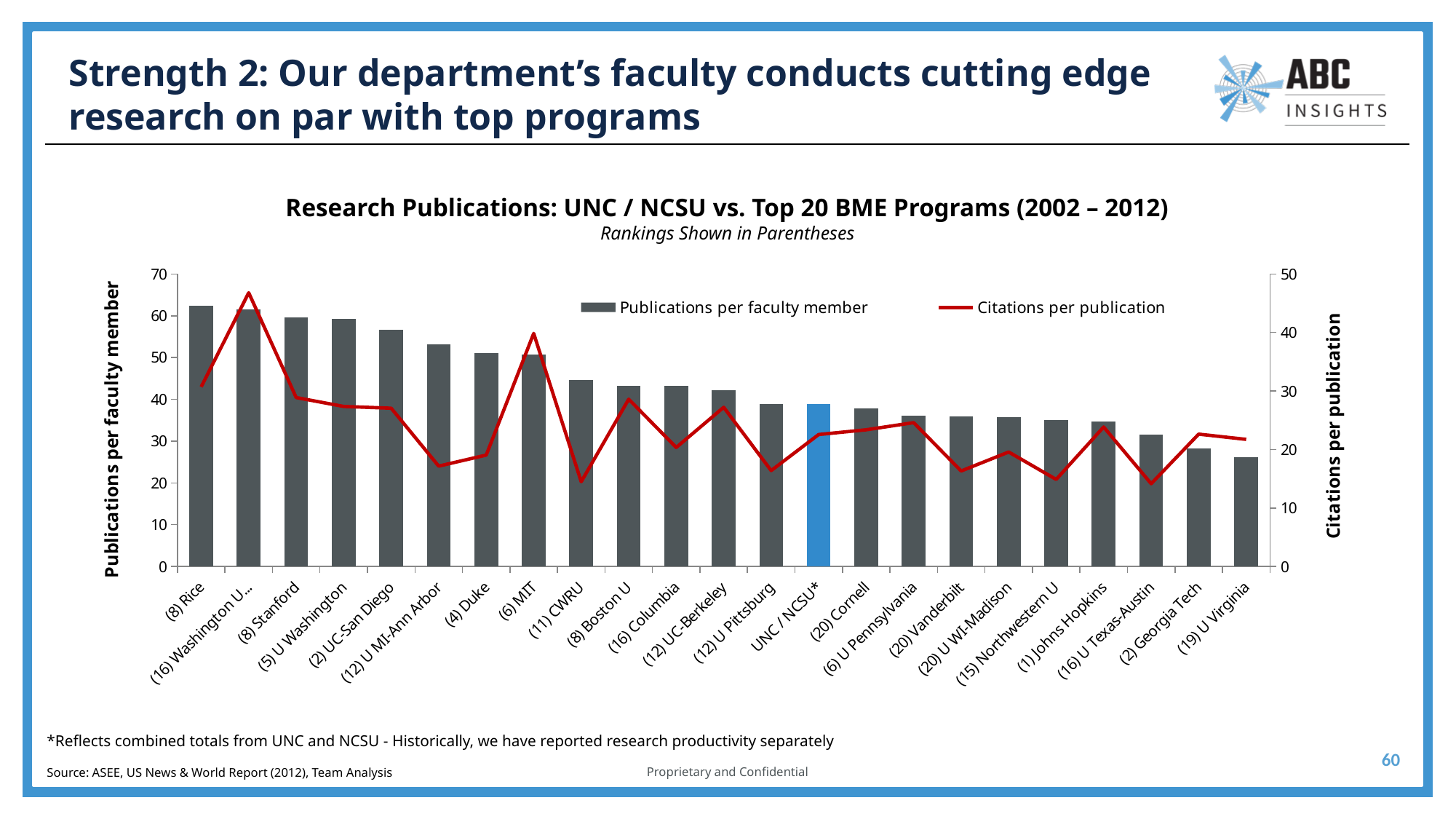
Is the value of citations per publication for (6) MIT greater or less than 30? greater Is the value of publications per faculty member for UNC / NCSU* greater or less than 30? greater What is the title of the chart? Research Publications: UNC / NCSU vs. Top 20 BME Programs (2002 – 2012) How many series does the chart legend list? 2 Is the value of citations per publication for (11) CWRU greater or less than 20? less Which program has the highest citations per publication? (16) Washington U How many programs (categories) are shown on the x axis of the chart? 23 Which has more publications per faculty member, (4) Duke or (20) Cornell? (4) Duke Do the publications per faculty member bars generally rise or fall from left to right across the x axis? fall Which program's bar is highlighted in blue rather than dark grey? UNC / NCSU* Which program has the lowest publications per faculty member? (19) U Virginia